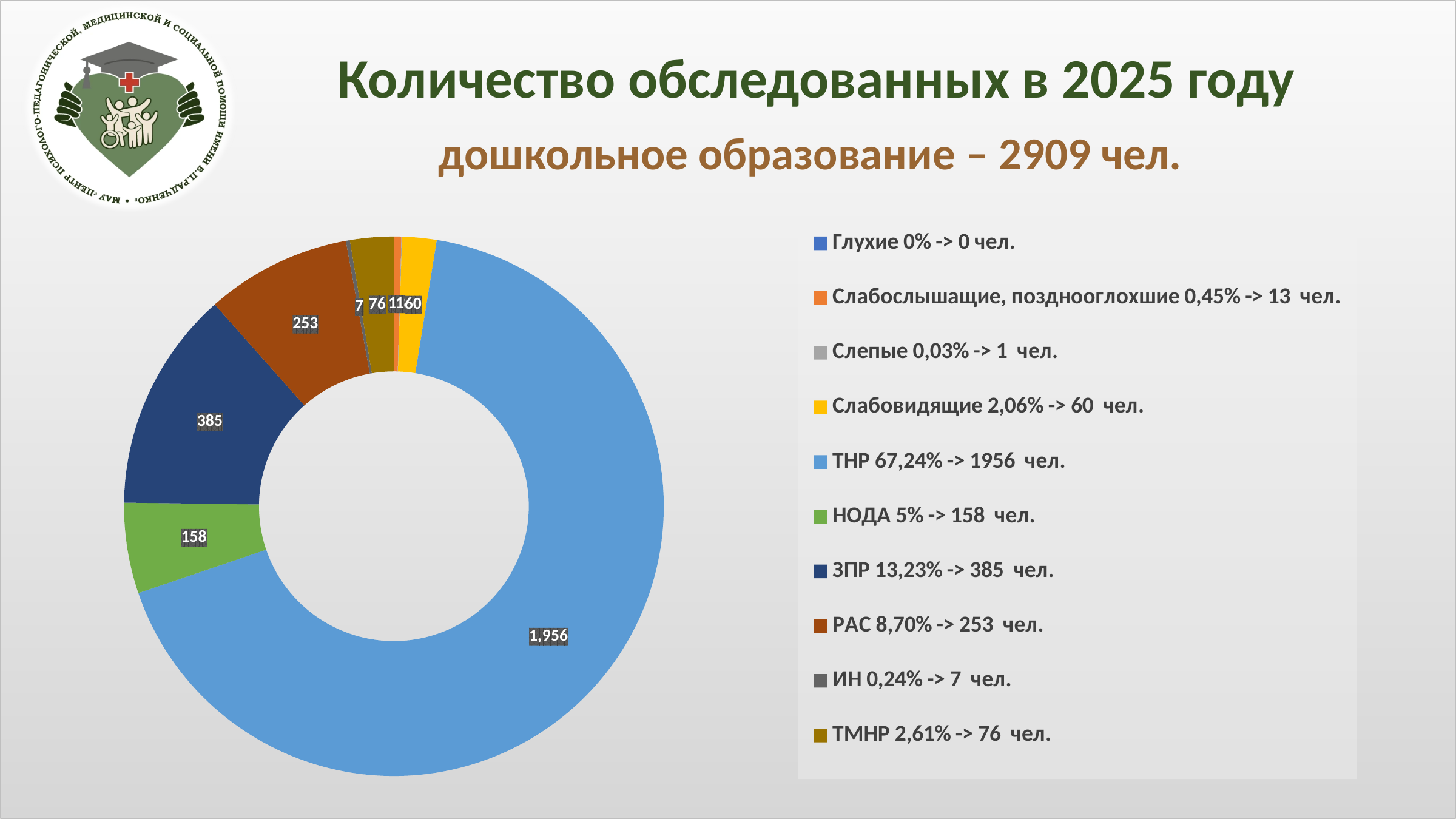
What colour is the ТНР slice? light blue What share of the pie does Слабовидящие represent? 2,06% Which category has the largest slice? ТНР What kind of chart is shown on the slide? pie chart (donut) How many categories does the legend list? 10 How many people are in the РАС category? 253 чел. Which category has the smallest non-zero value? Слепые How many people are in the ТНР category? 1956 чел. What is the difference between the ЗПР and НОДА values? 227 Which is larger, РАС or ТМНР? РАС What share of the pie does ЗПР represent? 13,23% What total number of people is stated in the subtitle for дошкольное образование? 2909 чел.